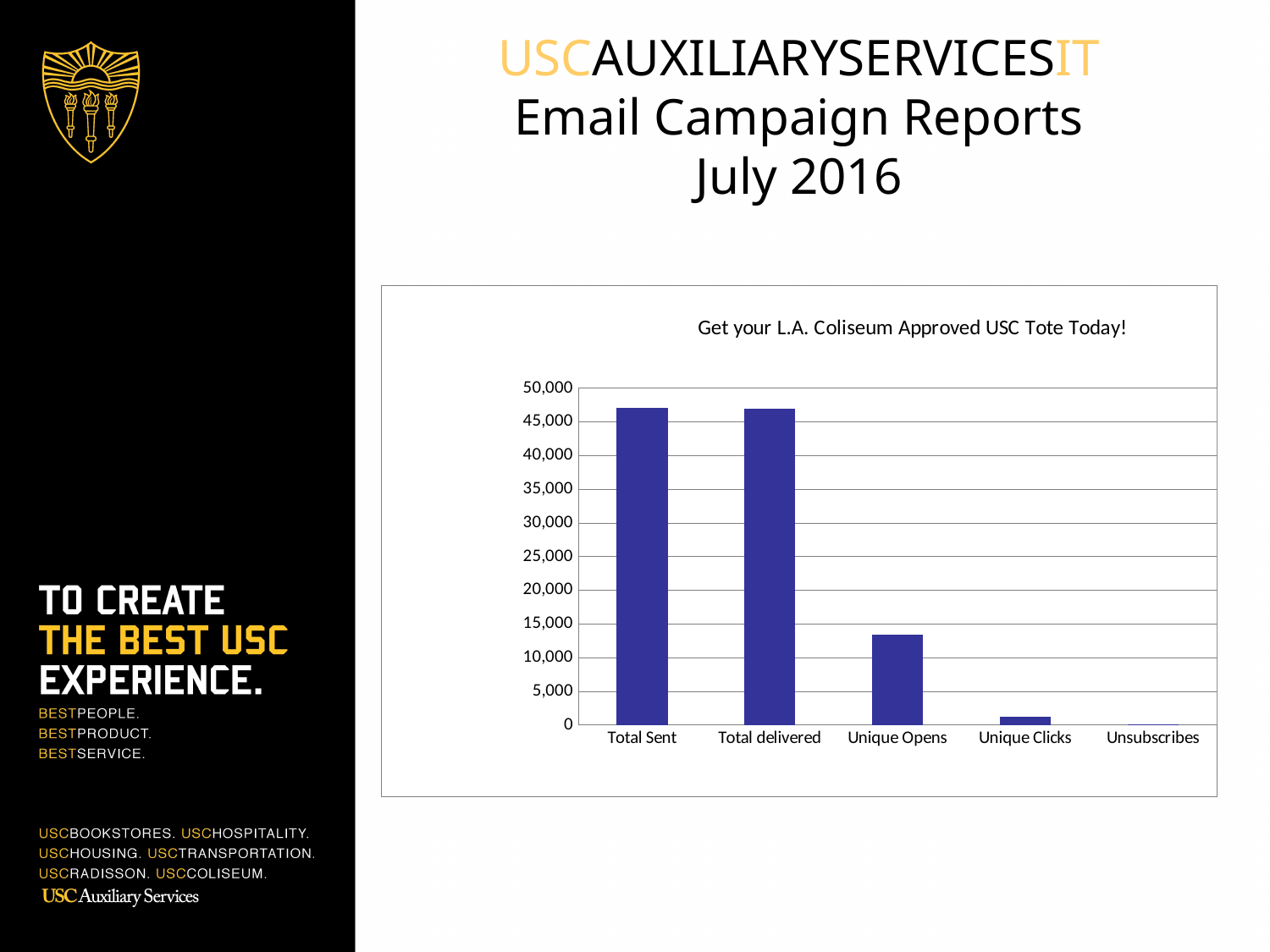
What is the title of the chart? Get your L.A. Coliseum Approved USC Tote Today! Which category has the lowest value in the chart? Unsubscribes Is the value for Total delivered greater or less than 40,000? greater Do the values generally rise or fall moving from left to right along the x axis? fall How many categories are shown on the x axis of the chart? 5 Which is larger, the value for Unique Clicks or the value for Unique Opens? Unique Opens Is the value for Unique Opens greater or less than 15,000? less Is the value for Unique Clicks greater or less than 5,000? less What kind of chart is shown on the slide? bar chart Which is larger, the value for Total delivered or the value for Unique Opens? Total delivered